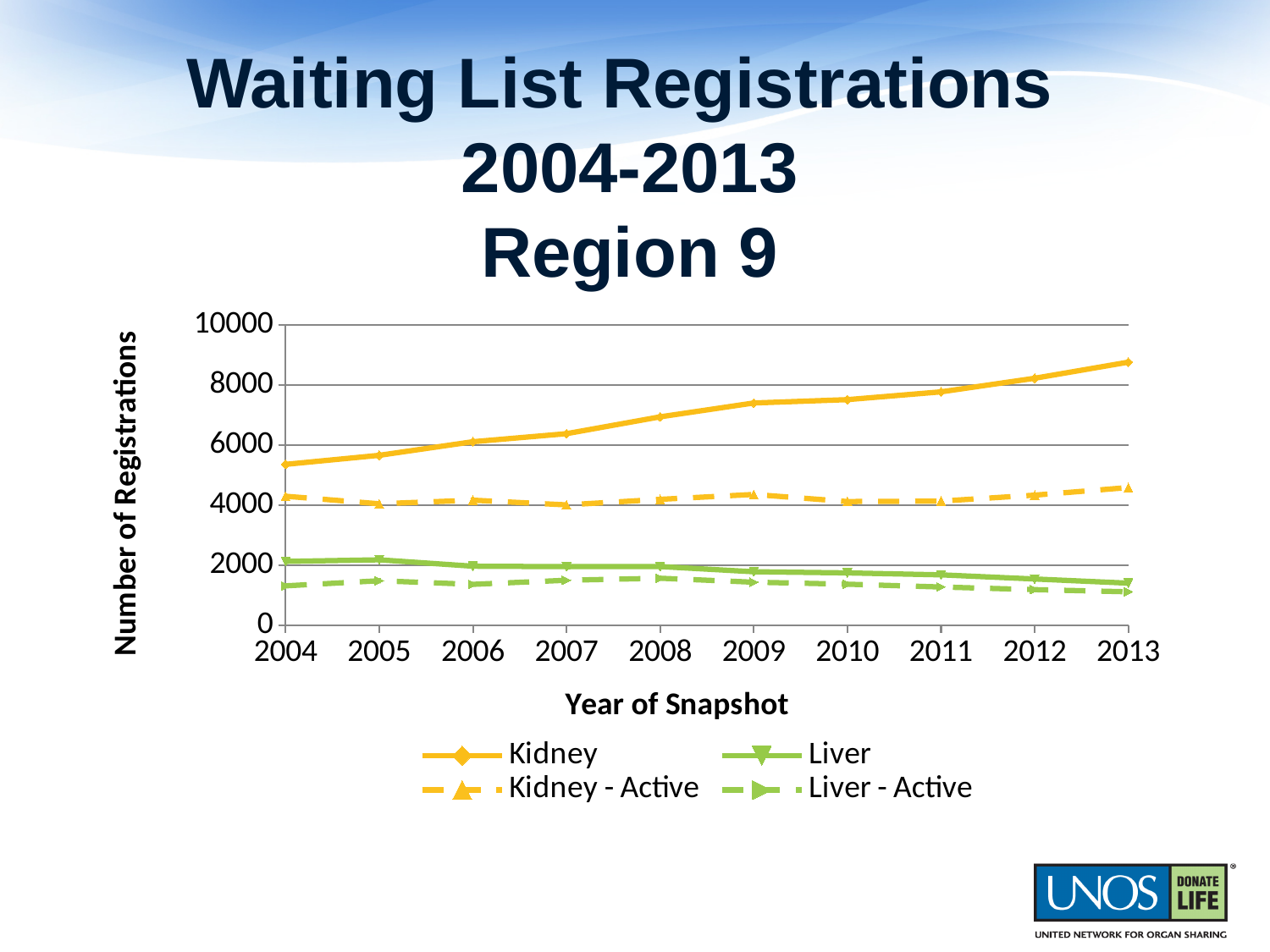
How many series does the legend list? 4 Is the value for Kidney in 2004 greater or less than 6000? less What is the title of the y axis? Number of Registrations What kind of chart is shown on the slide? line chart In 2013, which is larger, Kidney or Kidney - Active? Kidney In which year is the Kidney series lowest? 2004 Does the Liver series rise or fall from 2004 to 2013? fall In which year is the Kidney series highest? 2013 Is the value for Liver in 2013 greater or less than 2000? less Is the value for Kidney in 2013 greater or less than 8000? greater Does the Kidney series rise or fall from 2004 to 2013? rise How many years are plotted along the x axis? 10